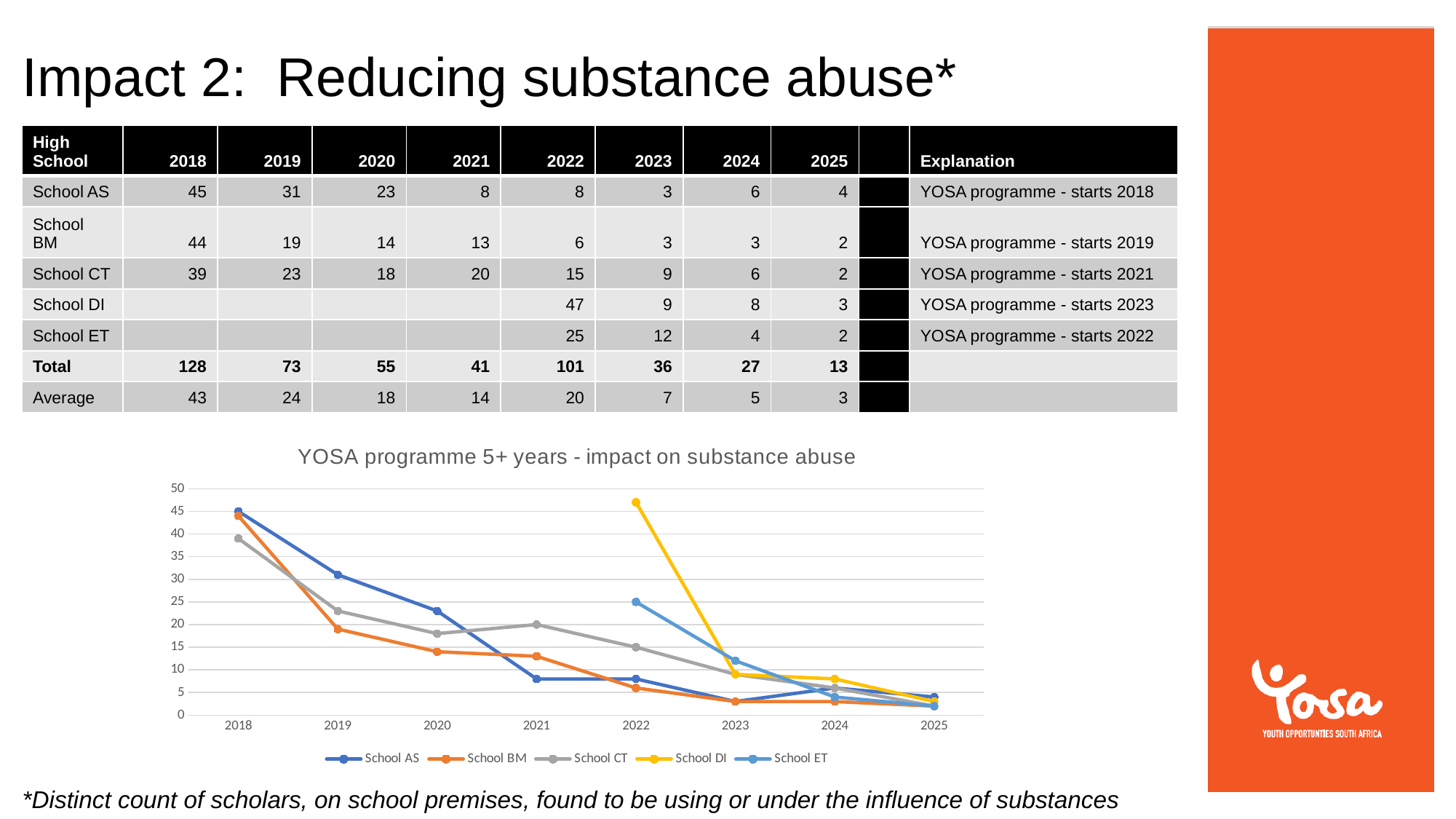
Is the value for School ET in 2022 greater or less than 20? greater What is the difference between the School AS value in 2018 and in 2025? 41 What is the value for School DI in 2022? 47 What is the value for School AS in 2018? 45 Do the values for School AS rise or fall from 2018 to 2025? fall How many series does the chart legend list? 5 In 2021, which is larger: the value for School CT or the value for School AS? School CT What is the title of the chart? YOSA programme 5+ years - impact on substance abuse What kind of chart is shown on the slide? line chart How many years are shown along the x axis of the chart? 8 Which school has the lowest value in 2018? School CT Which school has the highest value in 2022? School DI